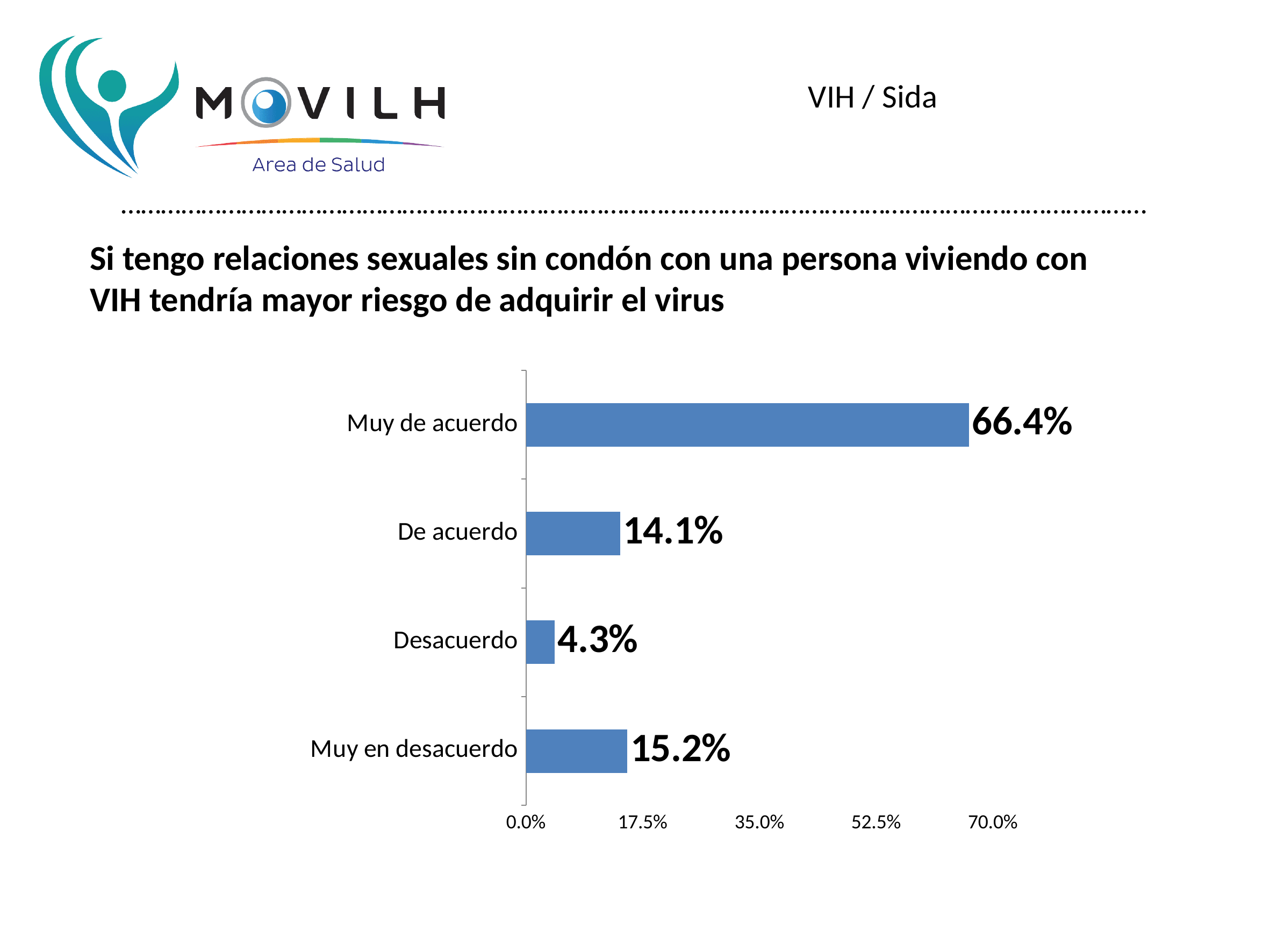
What is the difference between the values for "Muy en desacuerdo" and "Desacuerdo"? 10.9% Which category has the highest value? Muy de acuerdo What is the value for "Muy en desacuerdo"? 15.2% What kind of chart is shown on the slide? Bar chart Is the value for "Muy de acuerdo" greater or less than 52.5%? greater How many categories are shown in the chart? 4 What is the difference between the values for "Muy de acuerdo" and "De acuerdo"? 52.3% What is the value for "De acuerdo"? 14.1% Which is larger, the value for "Muy en desacuerdo" or the value for "De acuerdo"? Muy en desacuerdo What is the value for "Desacuerdo"? 4.3% What is the value for "Muy de acuerdo"? 66.4% Which category has the lowest value? Desacuerdo